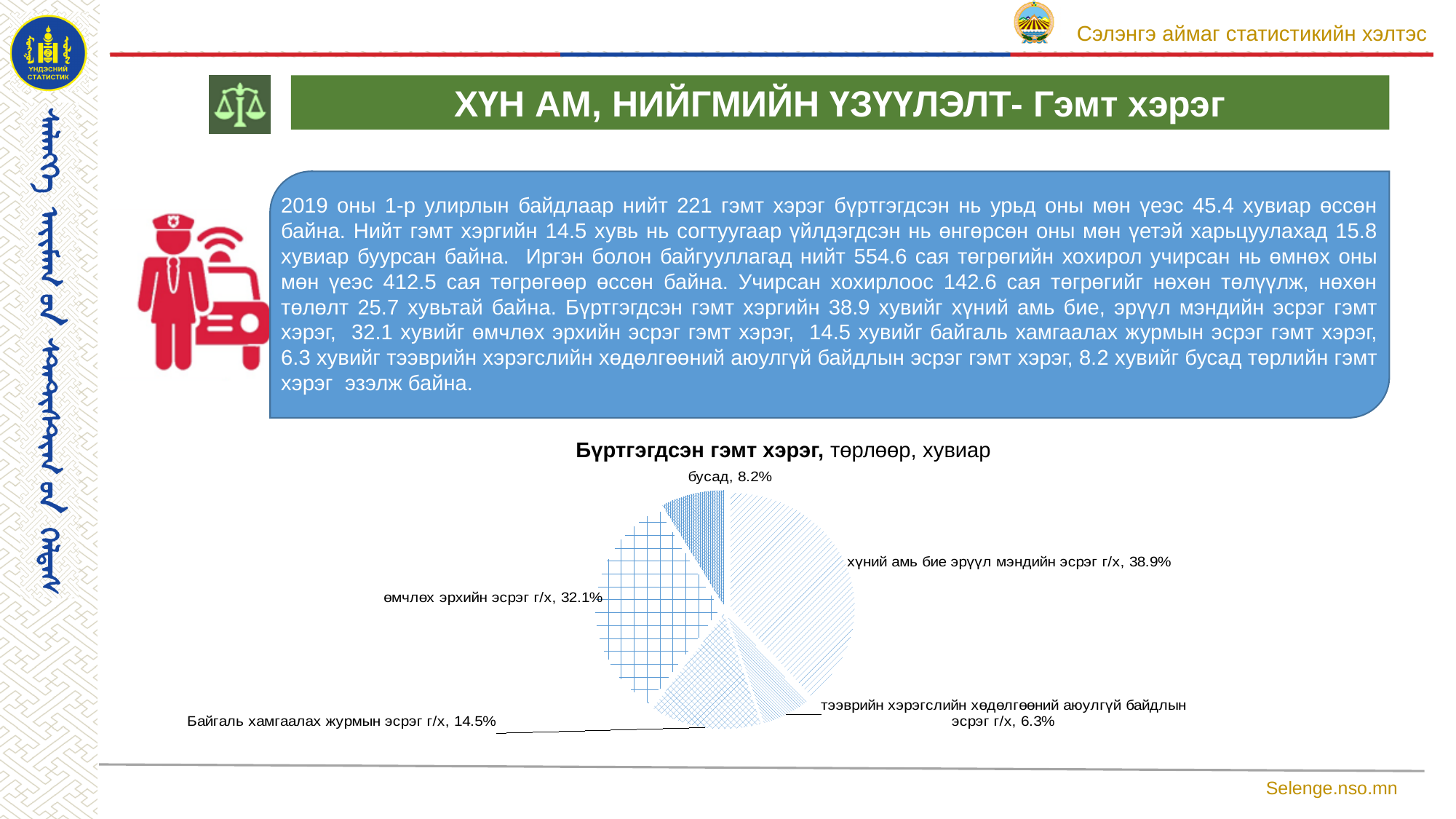
What share of the pie is 'бусад'? 8.2% What share of the pie is 'өмчлөх эрхийн эсрэг г/х'? 32.1% What share of the pie is 'Байгаль хамгаалах журмын эсрэг г/х'? 14.5% What share of the pie is 'тээврийн хэрэгслийн хөдөлгөөний аюулгүй байдлын эсрэг г/х'? 6.3% Which category has the smallest share of the pie? тээврийн хэрэгслийн хөдөлгөөний аюулгүй байдлын эсрэг г/х What is the title of the chart? Бүртгэгдсэн гэмт хэрэг, төрлөөр, хувиар How many slices does the pie chart have? 5 Which is larger: the share for 'бусад' or the share for 'тээврийн хэрэгслийн хөдөлгөөний аюулгүй байдлын эсрэг г/х'? бусад What kind of chart is shown on the slide? pie chart What share of the pie is 'хүний амь бие эрүүл мэндийн эсрэг г/х'? 38.9% What is the difference in percentage points between 'хүний амь бие эрүүл мэндийн эсрэг г/х' and 'өмчлөх эрхийн эсрэг г/х'? 6.8 Which category has the largest share of the pie? хүний амь бие эрүүл мэндийн эсрэг г/х